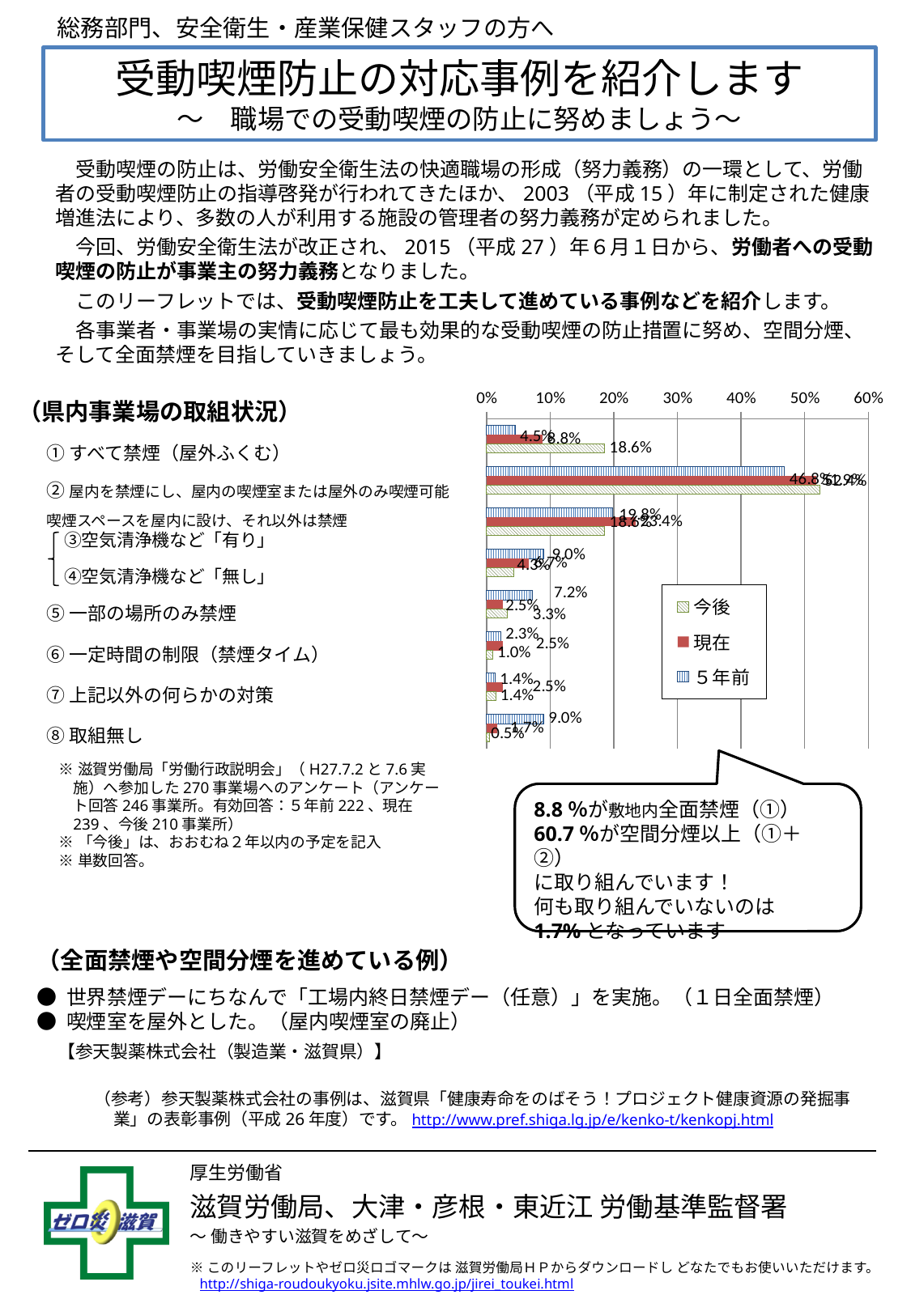
For category ①, which is larger: the 今後 value or the 5年前 value? 今後 What is the 5年前 value for category ① (すべて禁煙)? 4.5% Is the 今後 value for category ② greater or less than 50%? greater What are the three series named in the chart legend? 今後, 現在, 5年前 How many series does the chart legend list? 3 What kind of chart is shown on the slide? bar chart What is the 今後 value for category ① (すべて禁煙)? 18.6% What is the 5年前 value for category ② (屋内を禁煙にし、屋内の喫煙室または屋外のみ喫煙可能)? 46.8% What is the 現在 value for category ⑧ (取組無し)? 1.7% Which category has the highest values across all three series? ② 屋内を禁煙にし、屋内の喫煙室または屋外のみ喫煙可能 What is the 現在 value for category ① (すべて禁煙)? 8.8% How many categories (①–⑧) are plotted in the chart? 8